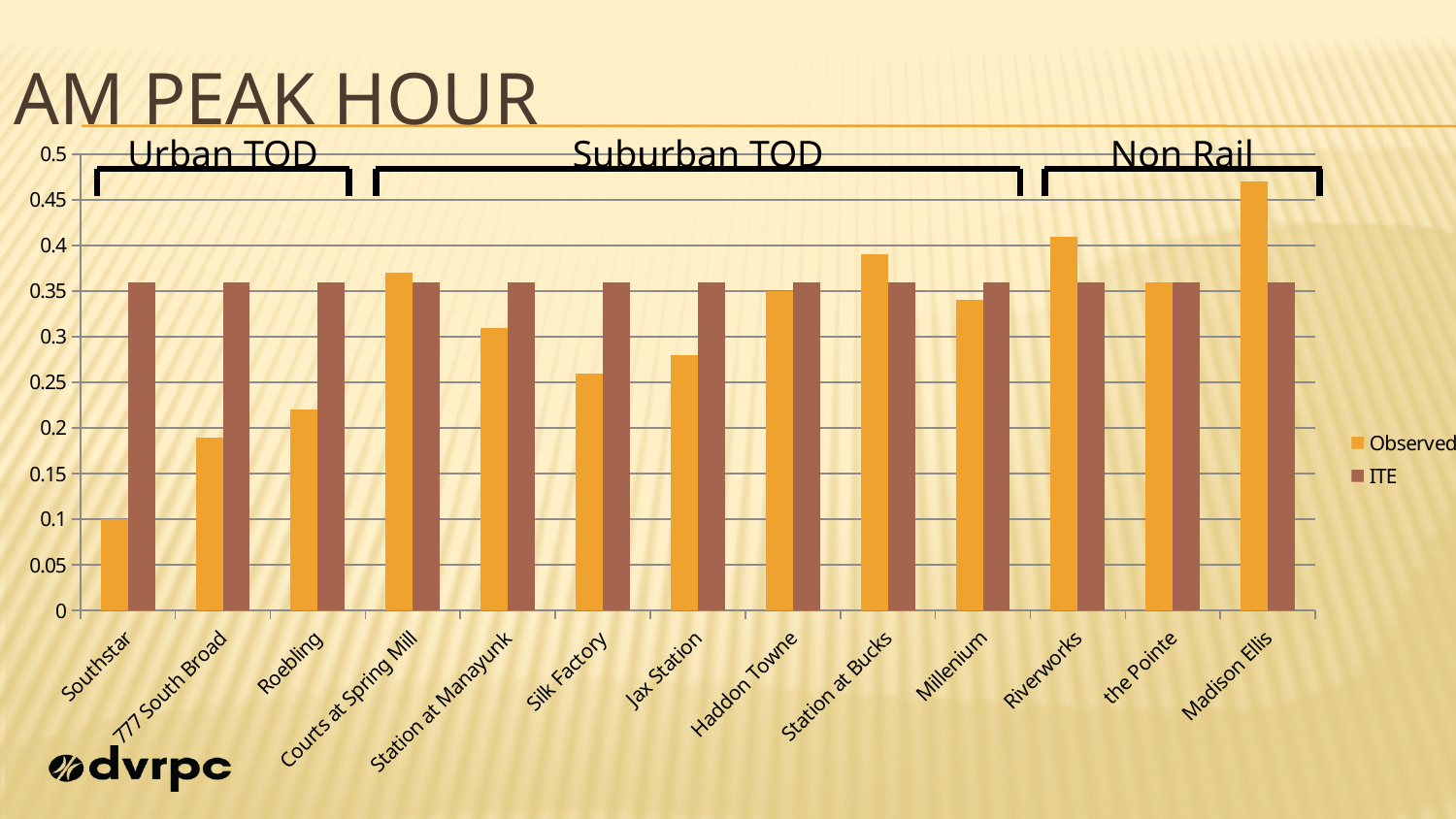
For Riverworks, which is larger, the Observed value or the ITE value? Observed Is the Observed value for Riverworks greater or less than 0.4? greater How many stations (categories) are shown on the x axis? 13 Is the Observed value for Jax Station greater or less than 0.3? less What kind of chart is shown on the slide? bar chart Is the Observed value for Madison Ellis greater or less than 0.45? greater Which station has the lowest Observed value? Southstar What is the title of the chart? AM PEAK HOUR How many series does the legend list? 2 Which station has the highest Observed value? Madison Ellis What is the Observed value for Southstar? 0.1